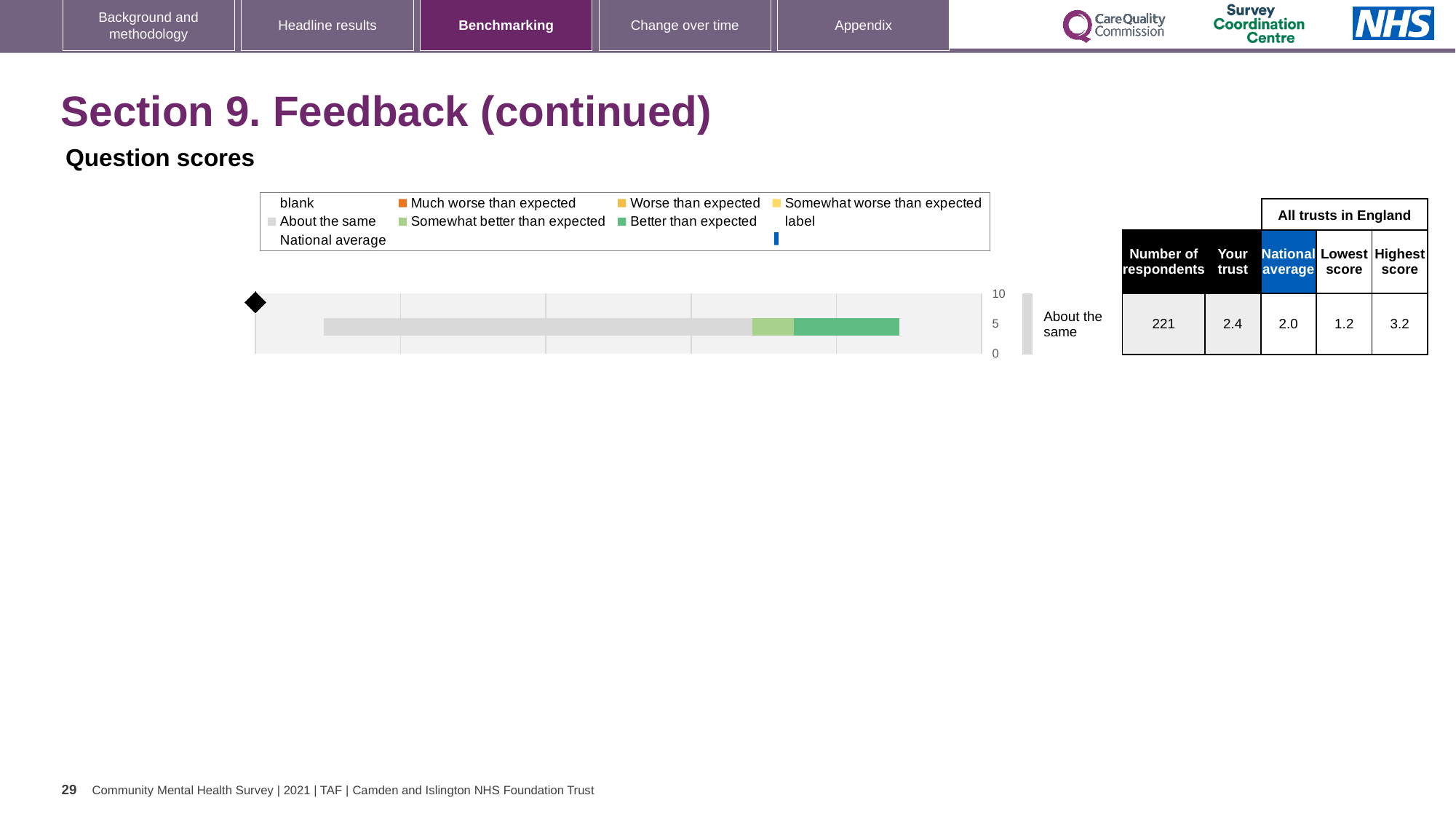
Which colour in the legend represents 'Better than expected'? green What is the National average score shown for the 'About the same' row? 2.0 What is the Lowest score among all trusts in England shown on the slide? 1.2 How many bars are plotted in the chart? 1 What is the Highest score among all trusts in England shown on the slide? 3.2 What is the difference between the 'Your trust' score and the National average score? 0.4 How many respondents are shown for the 'About the same' row? 221 What is the category label shown next to the bar in the chart? About the same Which is larger, the 'Your trust' score or the National average score? Your trust What is the 'Your trust' score for the 'About the same' row? 2.4 What kind of chart is shown on the slide? bar chart What is the difference between the Highest score and the Lowest score shown? 2.0